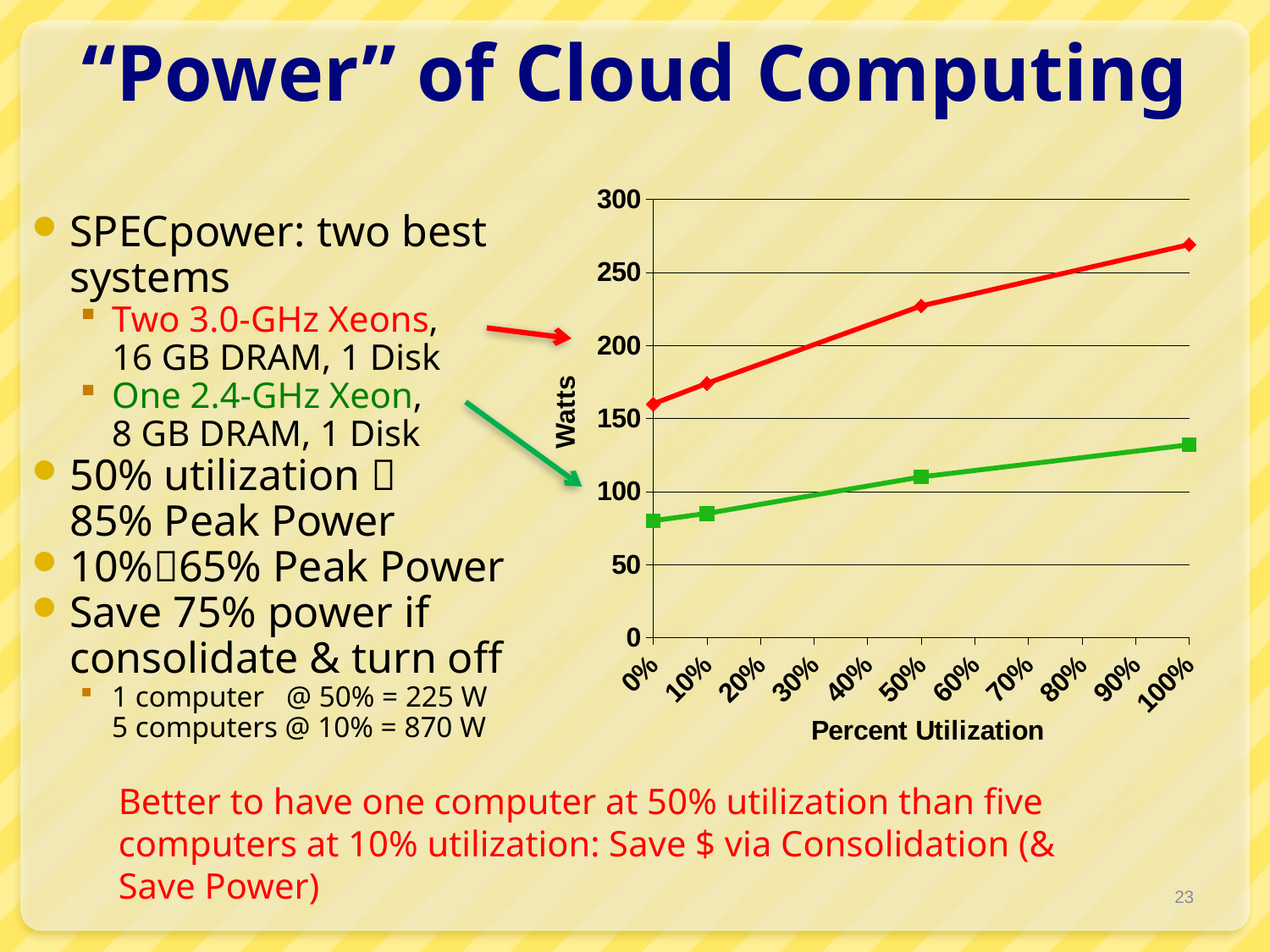
Which line has the higher value at 50% utilization, the red line or the green line? the red line How many lines are plotted on the chart? 2 Do the values of the red line rise or fall as percent utilization increases? rise Is the value of the red line at 100% utilization greater or less than 250 watts? greater Is the value of the green line at 0% utilization greater or less than 100 watts? less How many data points are marked on each line? 4 What kind of chart is shown on the slide? line chart Is the value of the green line at 100% utilization greater or less than 150 watts? less What is the label of the x axis? Percent Utilization What is the label of the y axis? Watts Do the values of the green line rise or fall as percent utilization increases? rise